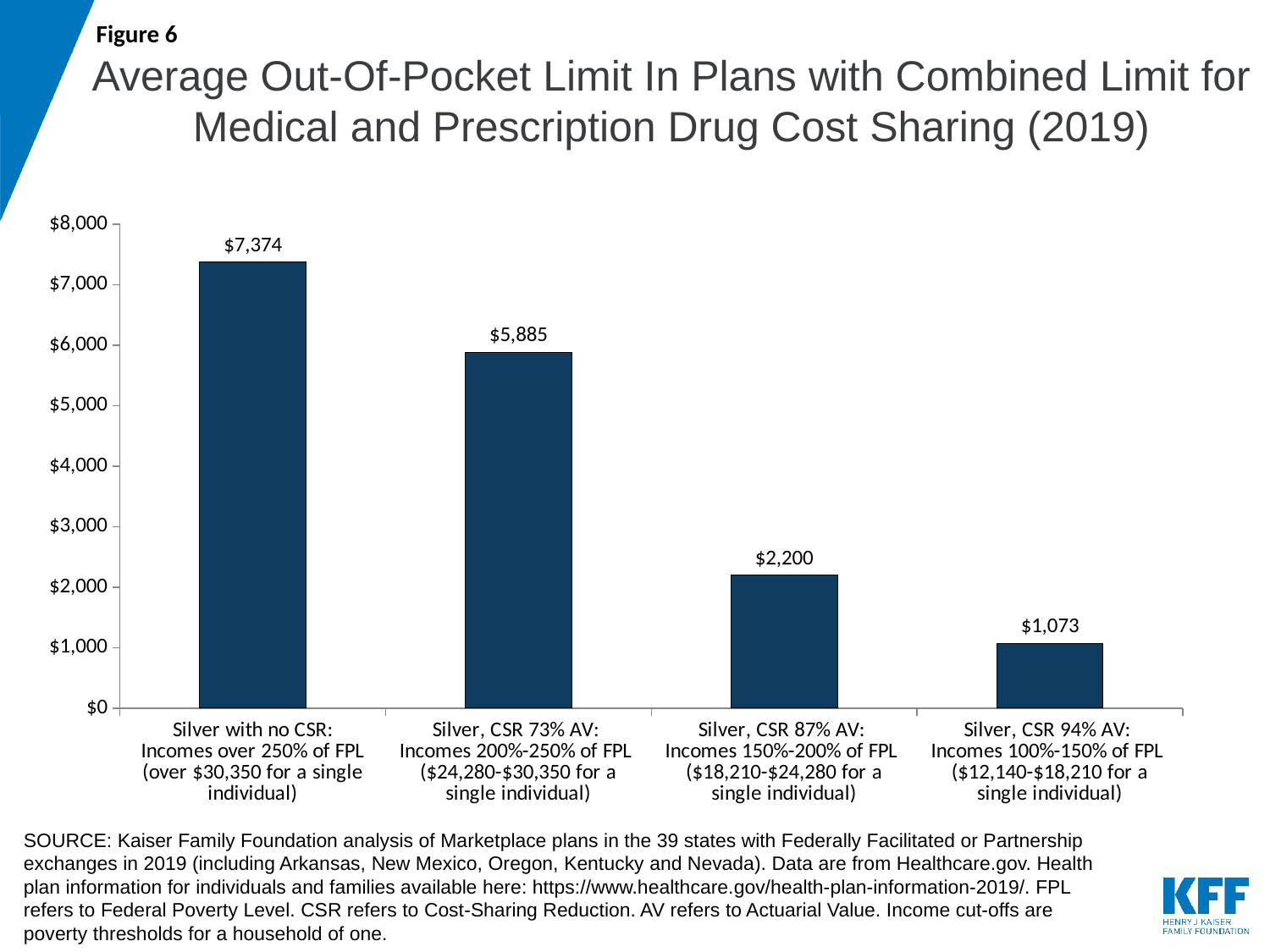
What is the average out-of-pocket limit for Silver, CSR 94% AV plans? $1,073 What is the difference between the average out-of-pocket limit for Silver, CSR 87% AV and Silver, CSR 94% AV? $1,127 Which plan category has the highest average out-of-pocket limit? Silver with no CSR How many plan categories are shown in the chart? 4 Do the values rise or fall moving from left to right across the categories? Fall Which has a larger average out-of-pocket limit: Silver, CSR 73% AV or Silver, CSR 87% AV? Silver, CSR 73% AV What is the average out-of-pocket limit for Silver, CSR 87% AV plans? $2,200 Which plan category has the lowest average out-of-pocket limit? Silver, CSR 94% AV What is the average out-of-pocket limit for Silver with no CSR plans? $7,374 What is the average out-of-pocket limit for Silver, CSR 73% AV plans? $5,885 What is the difference between the average out-of-pocket limit for Silver with no CSR and Silver, CSR 73% AV? $1,489 What kind of chart is shown on the slide? Bar chart